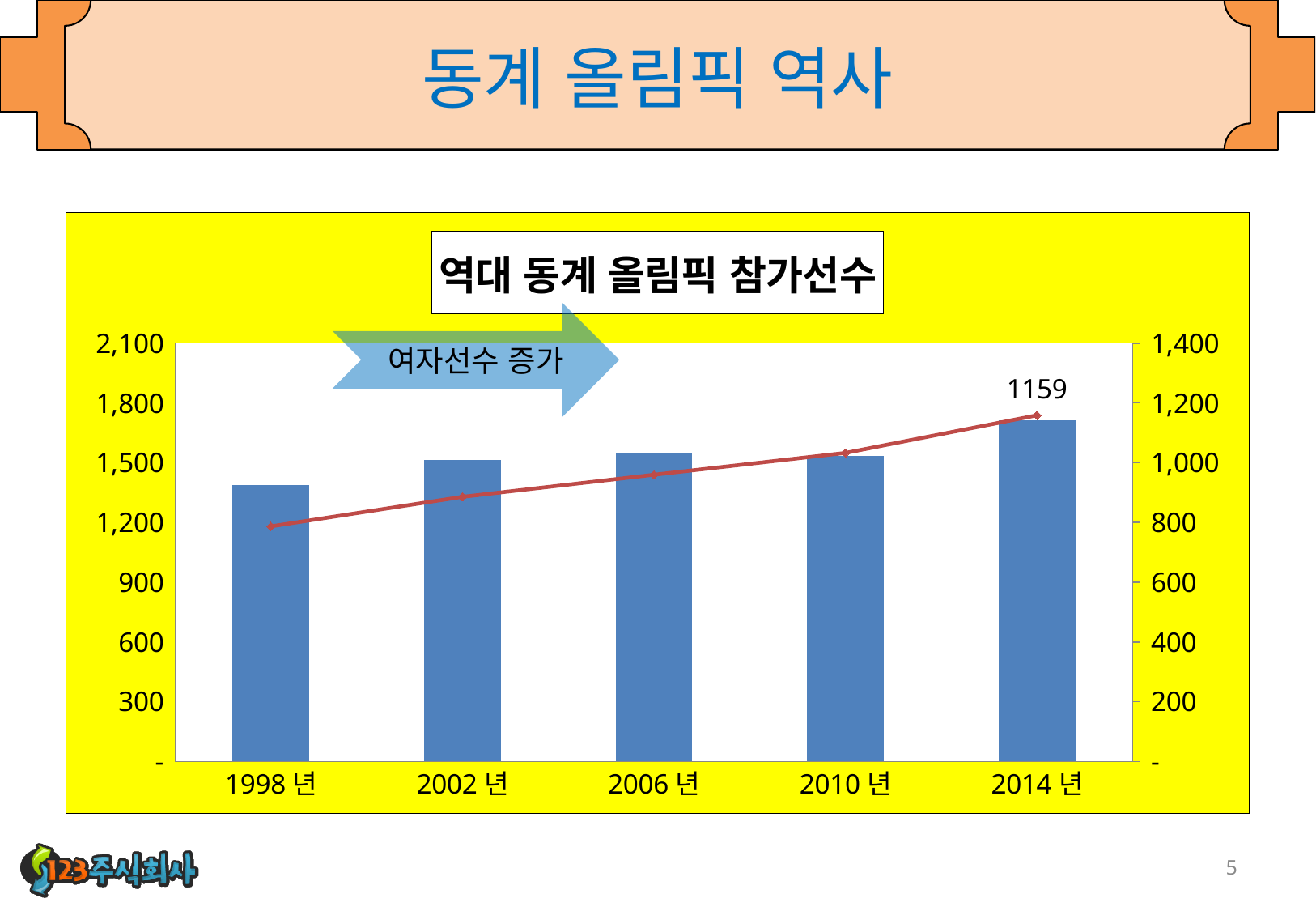
Which year has the tallest bar? 2014 년 Which bar is taller, 1998 년 or 2002 년? 2002 년 What text is written inside the arrow shape on the chart? 여자선수 증가 Is the line value for 2002 년 greater or less than 1,000 on the right axis? less Is the bar for 1998 년 greater or less than 1,500 on the left axis? less How many years are shown on the x axis of the chart? 5 What is the data label shown on the line at 2014 년? 1159 What is the title of the chart? 역대 동계 올림픽 참가선수 Which year has the shortest bar? 1998 년 What kind of chart is shown on the slide? A bar chart with a line overlaid Is the bar for 2014 년 greater or less than 1,500 on the left axis? greater Does the red line rise or fall from 1998 년 to 2014 년? Rises